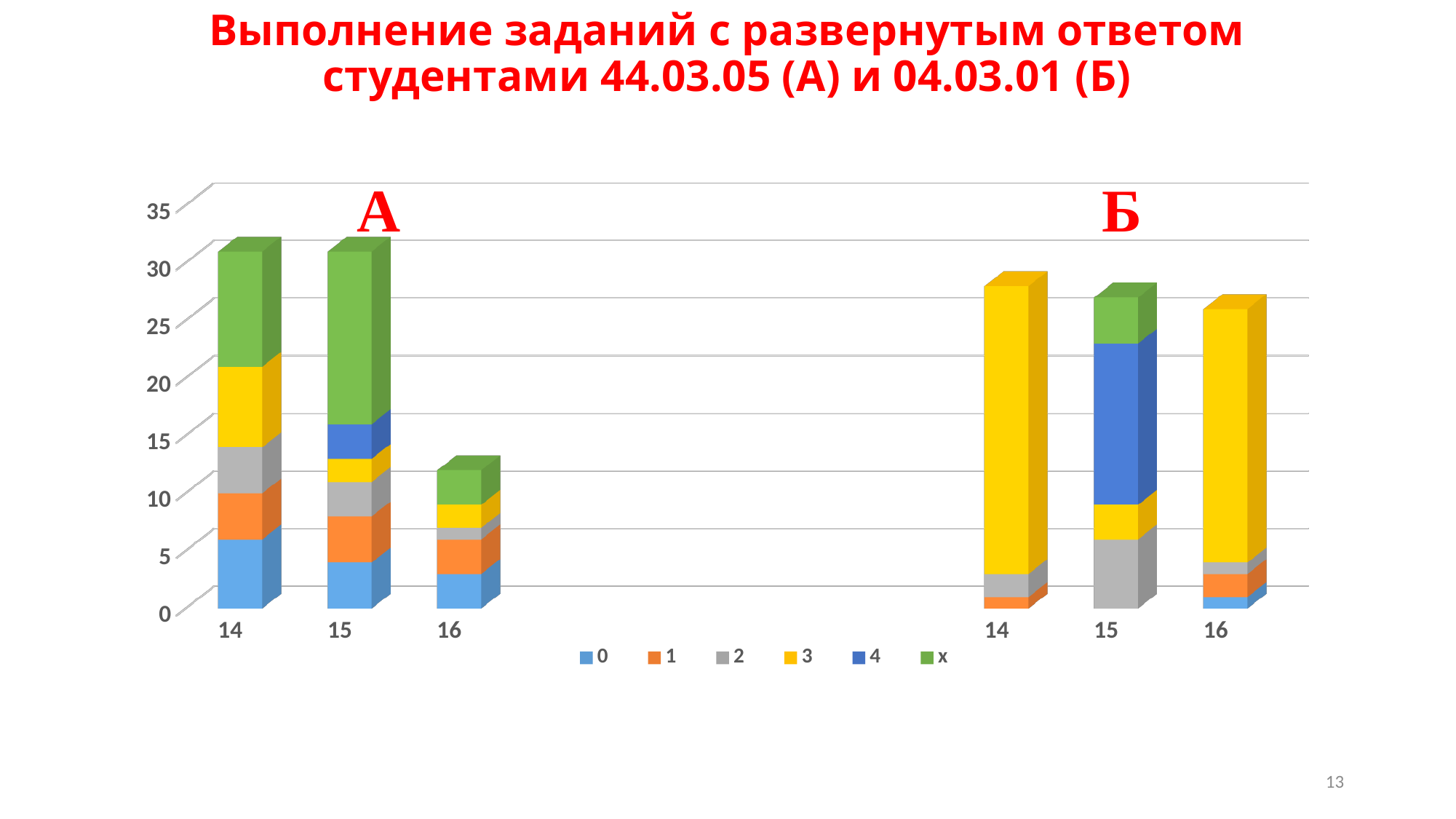
Which is taller: bar 16 in group A or bar 16 in group Б? 16 in group Б Is the total for bar 16 in group Б greater or less than 30? less How many bars are plotted in total across groups A and Б? 6 Which series is shown in green in the legend? x Is the total for bar 14 in group Б greater or less than 25? greater Is the total for bar 14 in group A greater or less than 25? greater How many series does the legend list? 6 Which is taller: bar 14 in group A or bar 14 in group Б? 14 in group A Which bar has the lowest total height on the chart? 16 in group A What kind of chart is shown on the slide? stacked bar chart What are the series names listed in the legend? 0, 1, 2, 3, 4, x